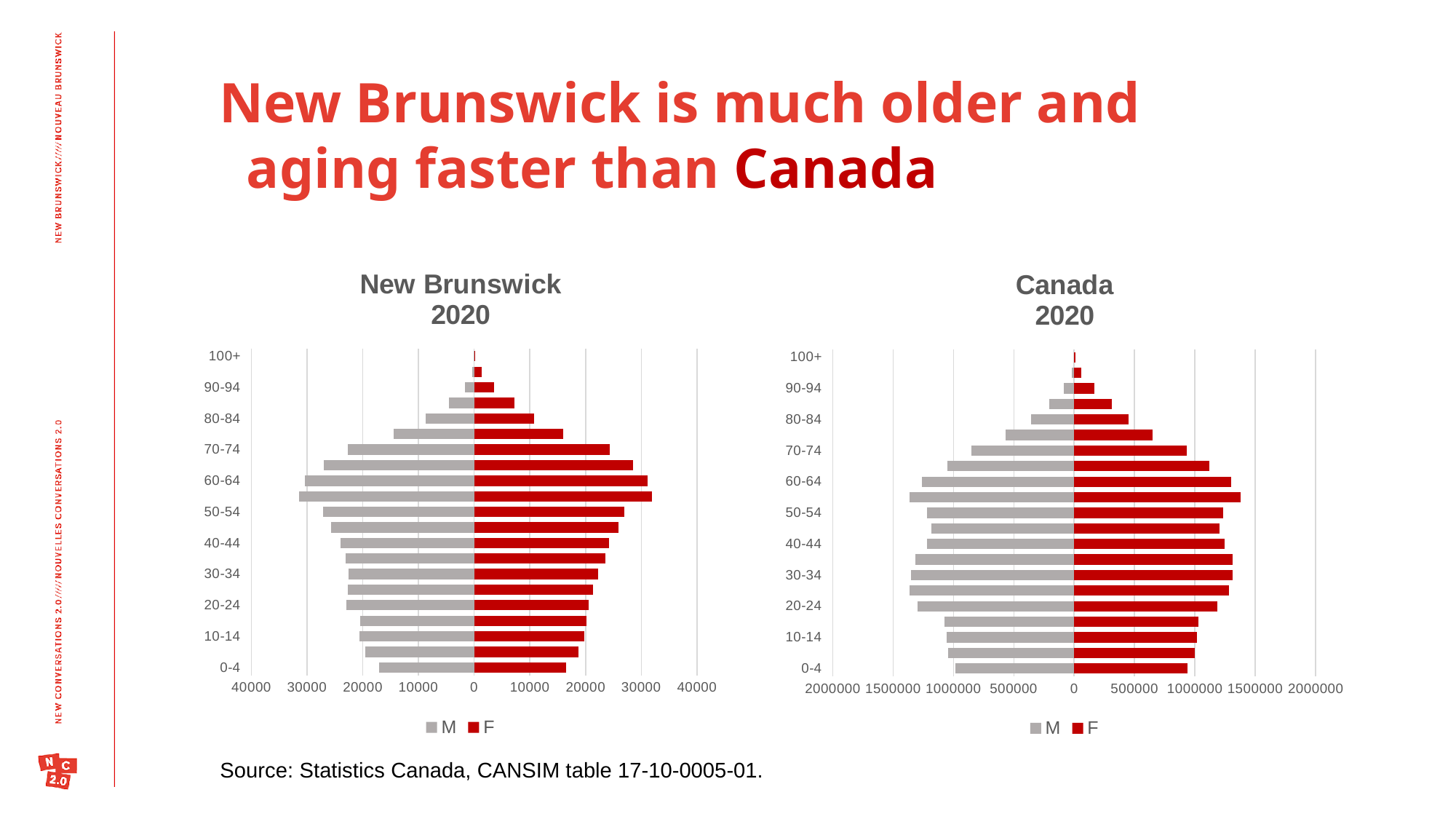
In the Canada 2020 chart, is the M value for the 80-84 age group greater or less than 500000? less What kind of chart is the New Brunswick 2020 chart? bar chart In the Canada 2020 chart, which F age group has the larger value, 60-64 or 0-4? 60-64 In the New Brunswick 2020 chart, is the F value for the 0-4 age group greater or less than 20000? less In the New Brunswick 2020 chart, is the M value for the 80-84 age group greater or less than 10000? less In the New Brunswick 2020 chart, which F age group has the larger value, 60-64 or 0-4? 60-64 In the New Brunswick 2020 chart, which series has the larger value for the 80-84 age group, M or F? F How many series does the legend of the Canada 2020 chart list? 2 In the Canada 2020 chart, which colour represents the F series? red